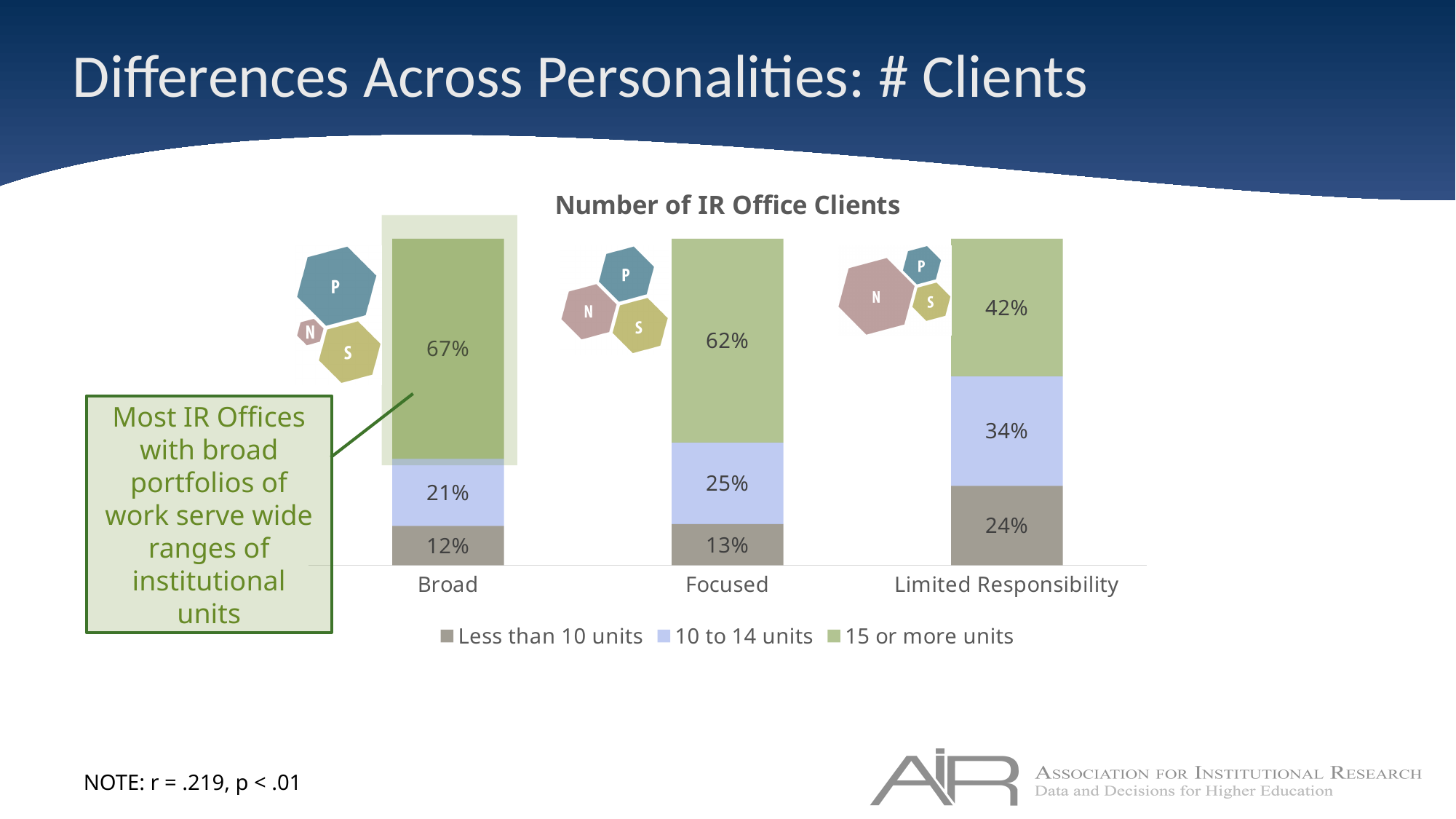
What percentage of Focused IR offices serve 10 to 14 units? 25% Which is larger: the 10 to 14 units share for Focused or for Limited Responsibility? Limited Responsibility What is the total of the three segments in the Focused bar? 100% What is the chart's title? Number of IR Office Clients How many categories are shown on the x axis? 3 What kind of chart is shown on the slide? Stacked bar chart Which category has the lowest share of offices serving less than 10 units? Broad What is the difference between the 15 or more units share for Broad and for Limited Responsibility? 25 percentage points What percentage of Limited Responsibility IR offices serve less than 10 units? 24% What percentage of Broad IR offices serve 15 or more units? 67% How many series does the legend list? 3 Which category has the highest share of offices serving 15 or more units? Broad